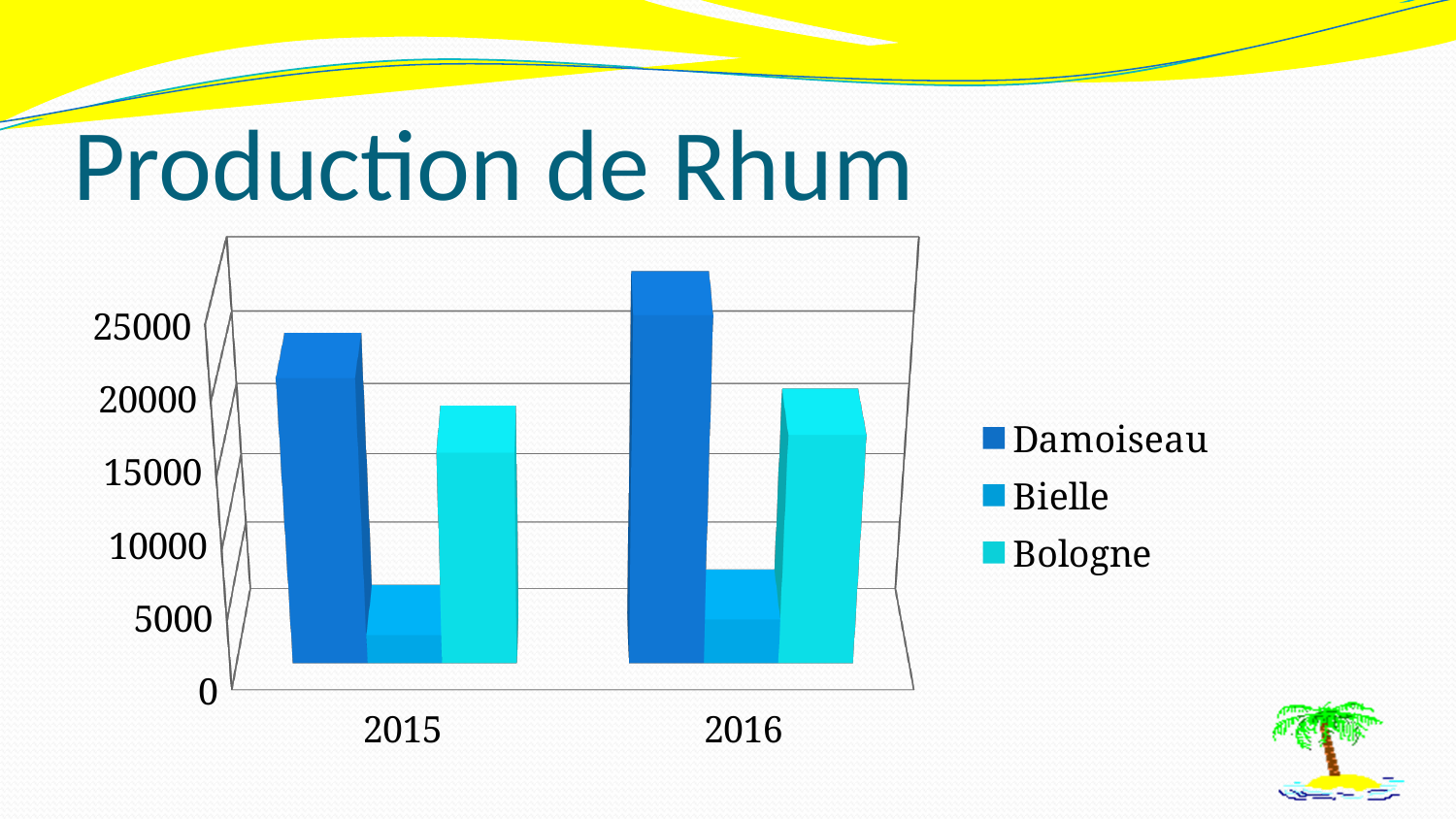
What kind of chart is shown on the slide? bar chart Does the value for Damoiseau rise or fall from 2015 to 2016? rise Which series has the lowest value in 2015? Bielle Is the value for Bielle in 2015 greater or less than 10000? less What is the title of the chart? Production de Rhum How many series does the legend list? 3 Which is larger: Damoiseau in 2015 or Damoiseau in 2016? Damoiseau in 2016 Which series has the highest value in 2016? Damoiseau How many categories are shown on the x axis? 2